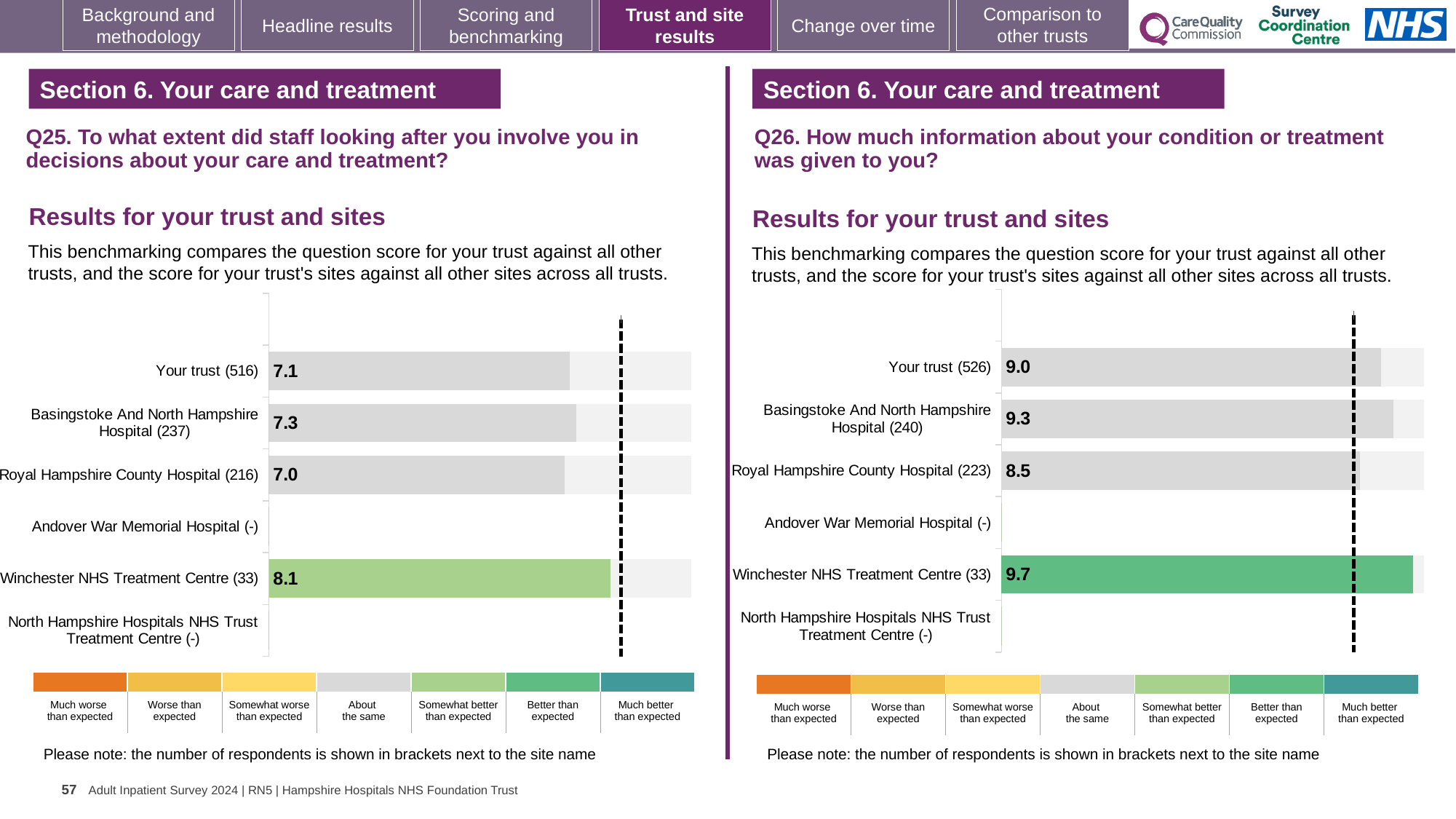
On the Q25 chart (left), how many sites have a plotted score bar? 3 On the Q25 chart (left), what is the score for Your trust (516)? 7.1 On the Q26 chart (right), what is the score for Royal Hampshire County Hospital (223)? 8.5 What kind of chart is used on the Q25 chart (left)? Bar chart On the Q26 chart (right), which site with a plotted score has the lowest score? Royal Hampshire County Hospital (223) On the Q25 chart (left), what is the difference between the scores for Basingstoke And North Hampshire Hospital (237) and Royal Hampshire County Hospital (216)? 0.3 On the Q26 chart (right), which benchmark category does the colour of the Winchester NHS Treatment Centre (33) bar correspond to? Better than expected On the Q25 chart (left), what is the score for Winchester NHS Treatment Centre (33)? 8.1 On the Q26 chart (right), which has the higher score: Your trust (526) or Basingstoke And North Hampshire Hospital (240)? Basingstoke And North Hampshire Hospital (240) On the Q26 chart (right), what is the score for Basingstoke And North Hampshire Hospital (240)? 9.3 On the Q25 chart (left), which site has the highest score? Winchester NHS Treatment Centre (33) On the Q26 chart (right), what is the difference between the scores for Winchester NHS Treatment Centre (33) and Your trust (526)? 0.7